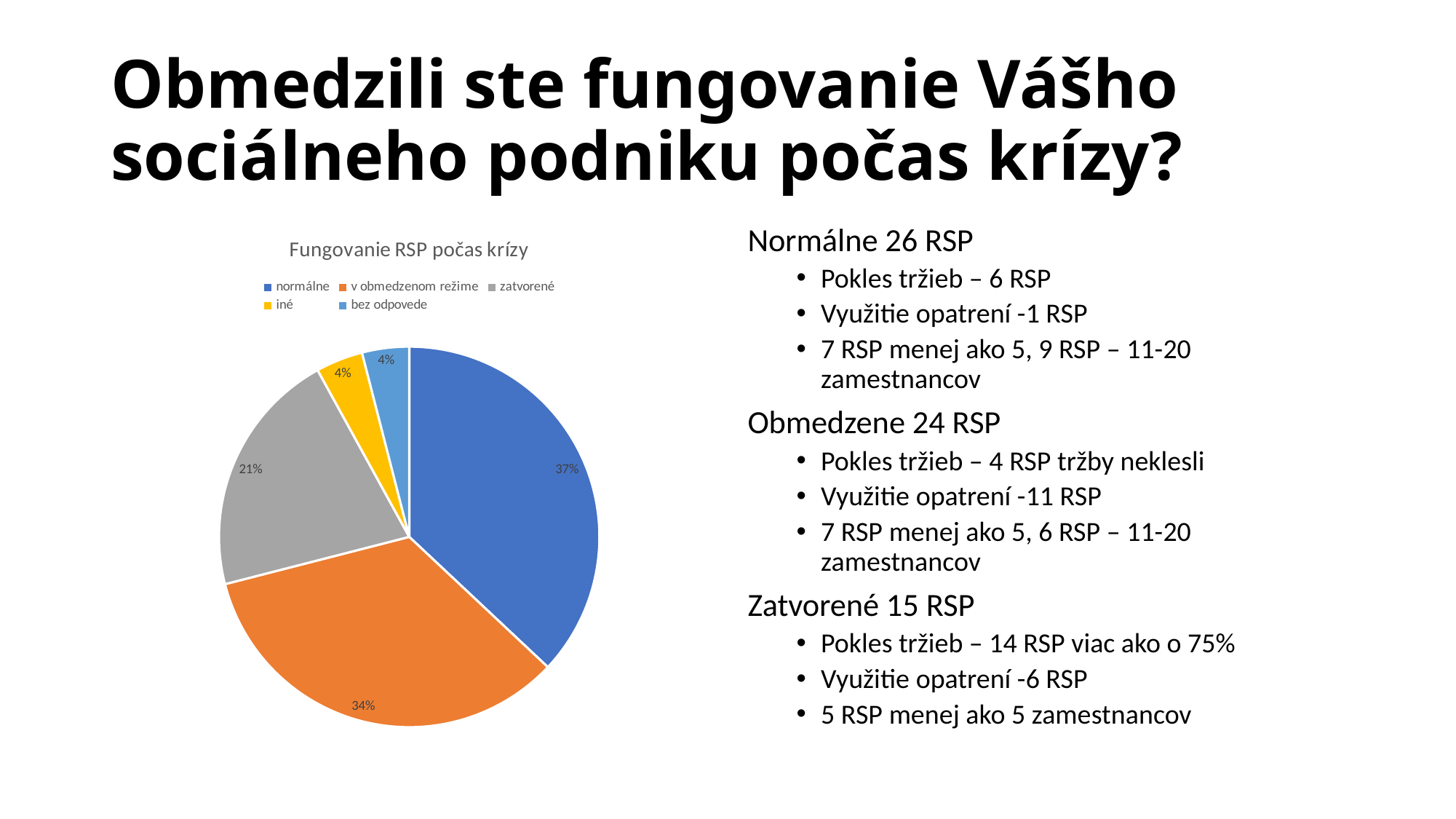
What share of the pie does the 'v obmedzenom režime' slice represent? 34% What share of the pie does the 'normálne' slice represent? 37% Which slice is larger, 'v obmedzenom režime' or 'zatvorené'? v obmedzenom režime Which category has the largest slice of the pie? normálne What is the title of the chart? Fungovanie RSP počas krízy Which colour represents 'zatvorené' in the pie chart? gray What is the difference in percentage points between the 'normálne' and 'zatvorené' slices? 16 How many categories does the legend of the pie chart list? 5 What share of the pie does the 'zatvorené' slice represent? 21% What kind of chart is shown on the slide? pie chart